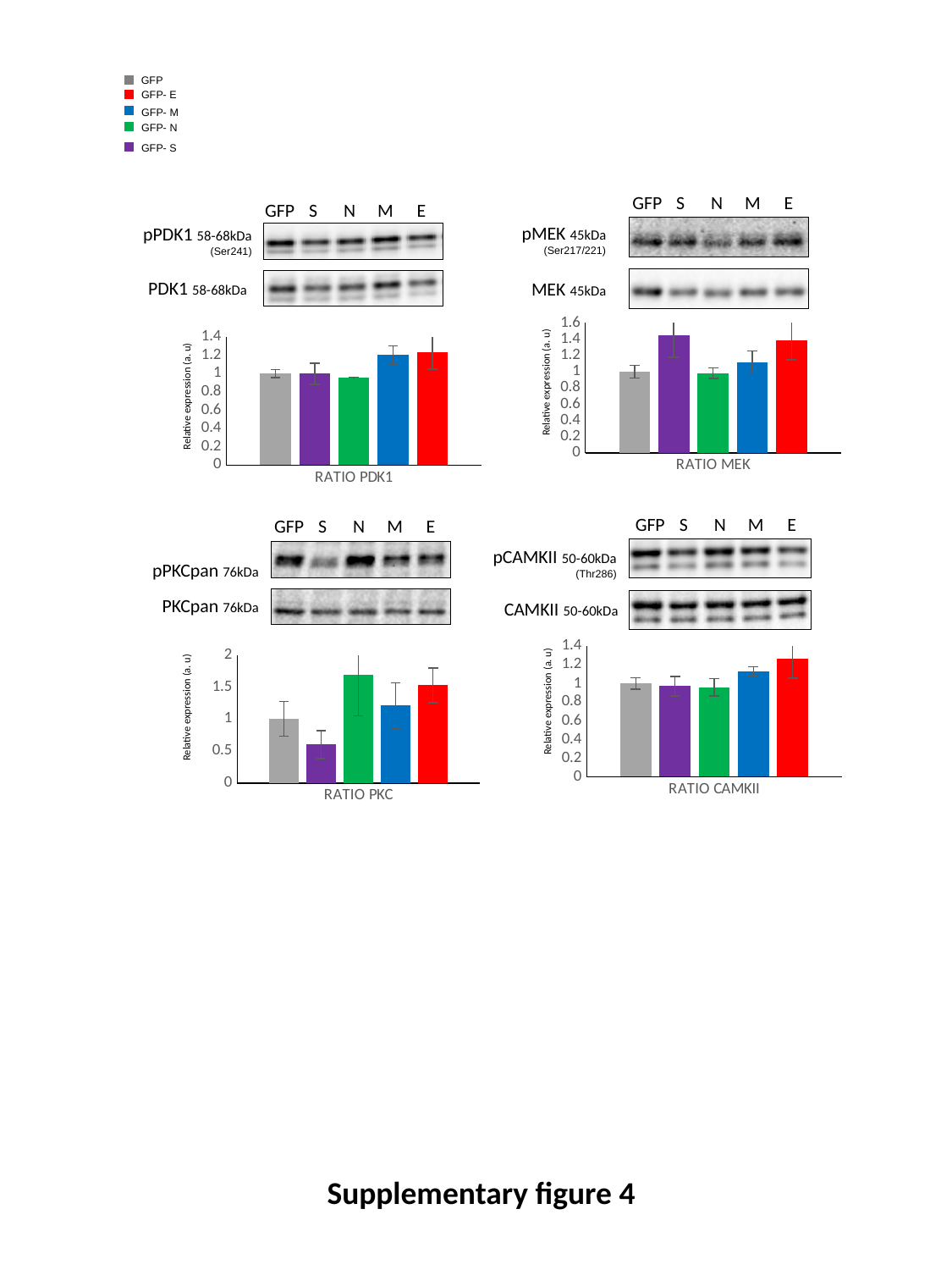
In the RATIO PKC chart, is the value for GFP- N greater or less than 1.5? greater According to the legend, what colour represents GFP- S? purple In the RATIO MEK chart, is the value for GFP- S greater or less than 1.2? greater What kind of chart is the RATIO PKC chart? bar chart In the RATIO PKC chart, is the value for GFP- S greater or less than 1? less In the RATIO CAMKII chart, which group has the highest bar? GFP- E In the RATIO PKC chart, which group has the highest bar? GFP- N How many series does the legend at the top of the slide list? 5 In the RATIO PKC chart, which group has the lowest bar? GFP- S How many bars are plotted in the RATIO PDK1 chart? 5 In the RATIO MEK chart, which is larger, the value for GFP- S or the value for GFP- N? GFP- S